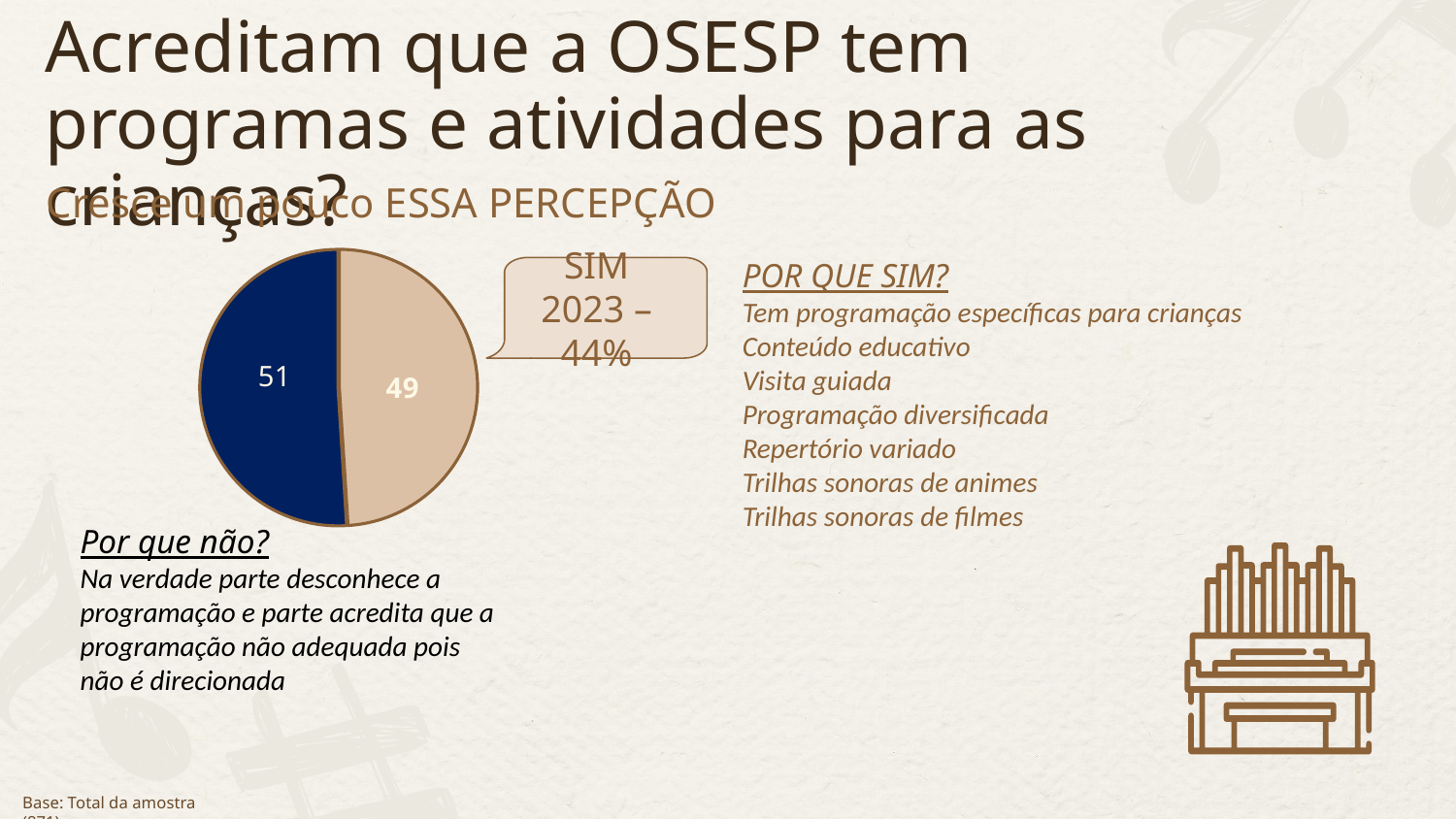
What value is printed on the dark blue slice of the pie chart? 51 Which slice of the pie chart has the larger value, the dark blue one or the tan one? Dark blue What kind of chart is shown on the slide? Pie chart What is the difference between the two values shown in the pie chart? 2 What is the largest value shown in the pie chart? 51 What subtitle appears directly above the pie chart? Cresce um pouco ESSA PERCEPÇÃO What share of the pie does the dark blue slice represent, based on the printed values? 51% What percentage for 'SIM' in 2023 is shown in the callout next to the pie chart? 44% What is the total of the two values printed on the pie chart? 100 What value is printed on the tan (beige) slice of the pie chart? 49 What is the smallest value shown in the pie chart? 49 How many slices does the pie chart have? 2